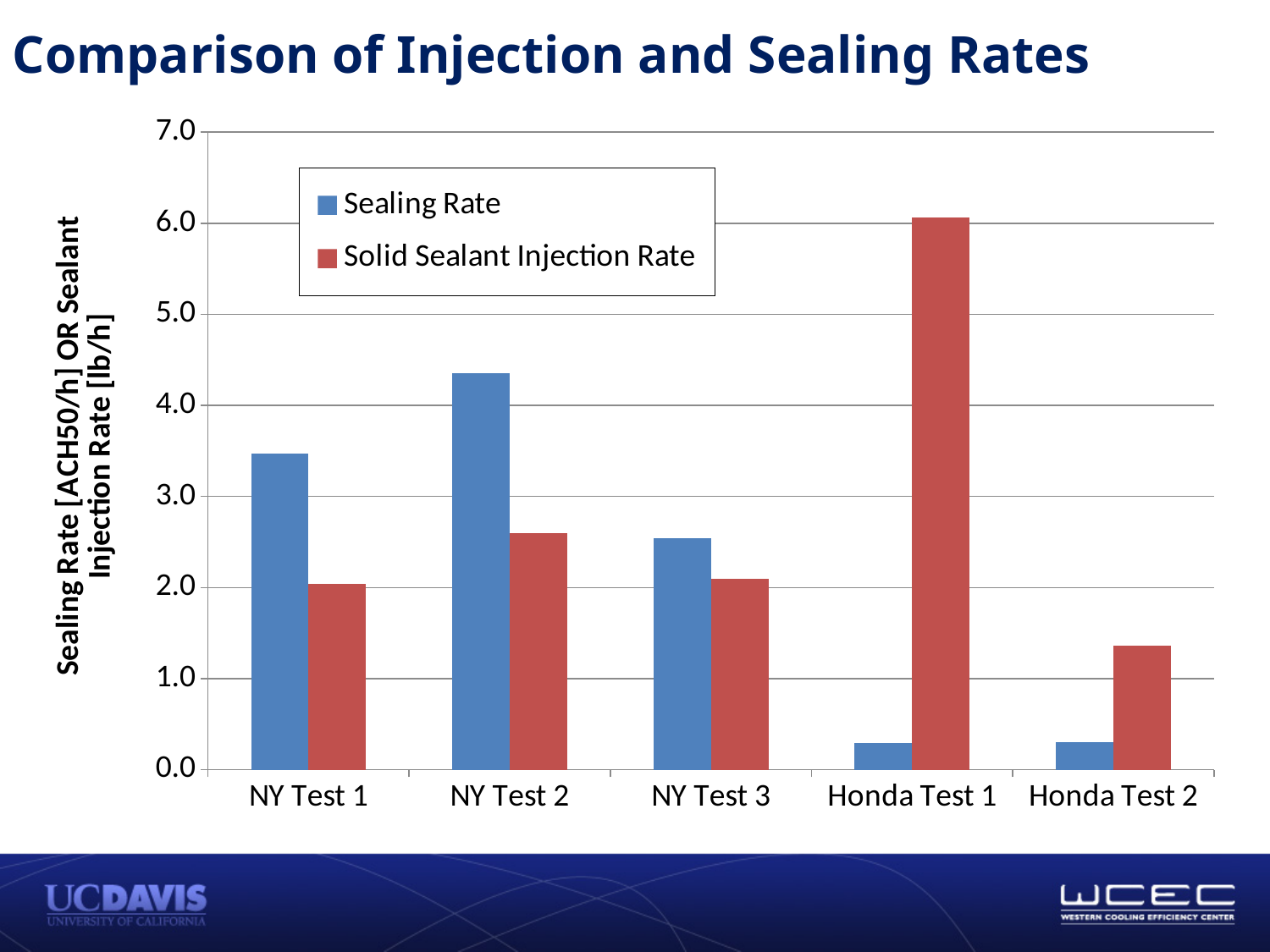
What kind of chart is shown on the slide? bar chart Which test has the lowest Solid Sealant Injection Rate? Honda Test 2 Is the Sealing Rate for NY Test 2 greater or less than 4.0? greater How many test categories are shown on the x axis? 5 Is the Solid Sealant Injection Rate for Honda Test 1 greater or less than 5.0? greater Is the Sealing Rate for NY Test 3 greater or less than 3.0? less Which test has the highest Solid Sealant Injection Rate? Honda Test 1 Which colour represents the Solid Sealant Injection Rate series in the legend? red For Honda Test 1, which is larger: the Sealing Rate or the Solid Sealant Injection Rate? Solid Sealant Injection Rate How many series does the legend list? 2 For NY Test 1, which is larger: the Sealing Rate or the Solid Sealant Injection Rate? Sealing Rate Which test has the highest Sealing Rate? NY Test 2